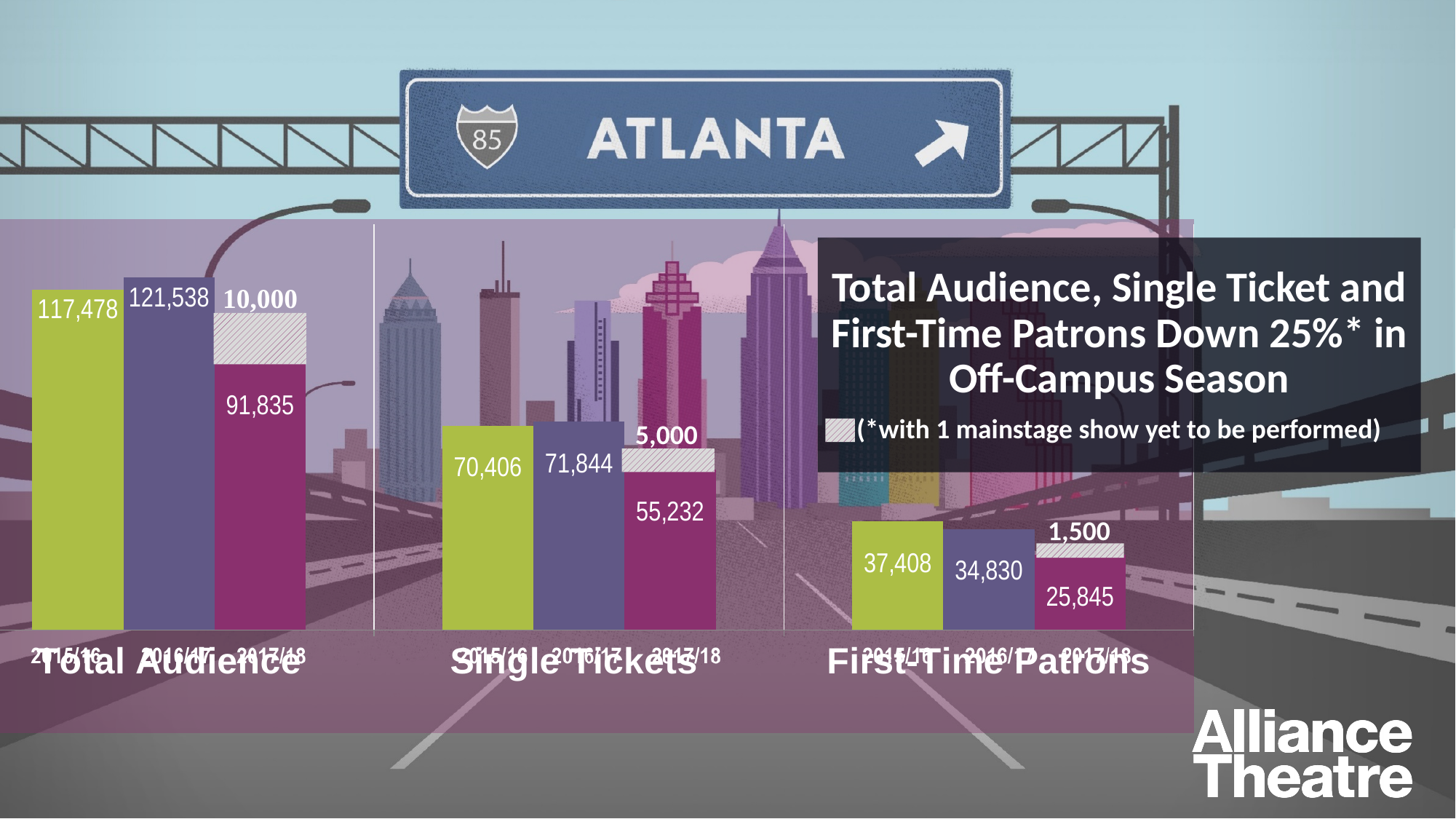
What is the solid (performed-to-date) First-Time Patrons value for 2017/18? 25,845 Which is larger, First-Time Patrons in 2015/16 or in 2016/17? 2015/16 What is the hatched projected amount shown on top of the 2017/18 Single Tickets bar? 5,000 Which season has the highest Total Audience? 2016/17 According to the slide's title, by what percentage are Total Audience, Single Ticket and First-Time Patrons down in the Off-Campus Season? 25% What is the 2017/18 Total Audience including the hatched projected portion? 101,835 How much larger is the Total Audience in 2016/17 than in 2015/16? 4,060 Which season has the lowest First-Time Patrons value? 2017/18 What is the Single Tickets value for 2016/17? 71,844 What is the Total Audience value for 2015/16? 117,478 How many category groups (Total Audience, Single Tickets, First-Time Patrons) are shown on the chart? 3 What kind of chart is shown on the slide? Bar chart